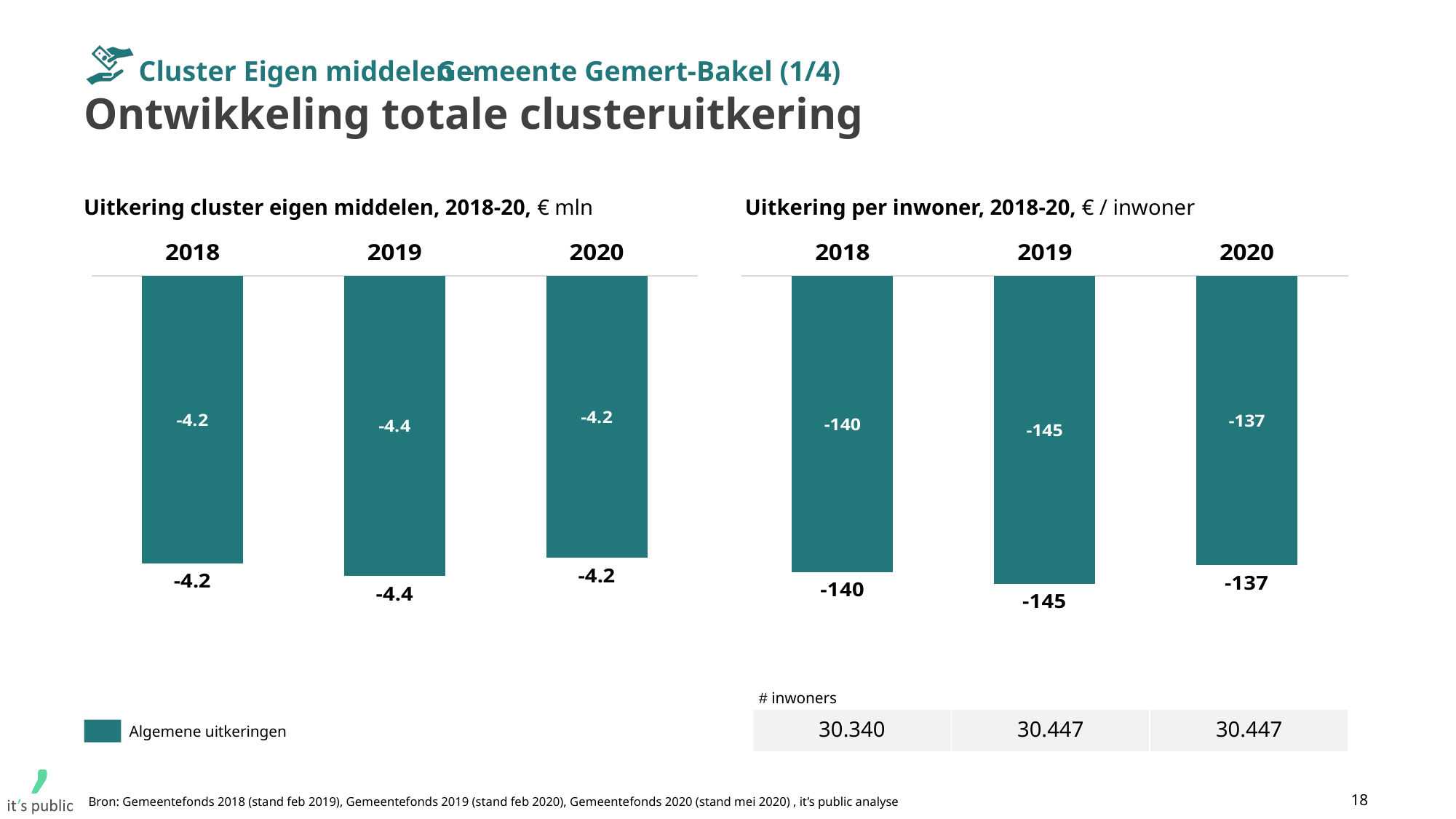
In the chart 'Uitkering cluster eigen middelen, 2018-20', which year has the lowest value? 2019 In the chart 'Uitkering cluster eigen middelen, 2018-20', what is the value for 2020? -4.2 In the chart 'Uitkering per inwoner, 2018-20', which year has the lowest value? 2019 In the chart 'Uitkering per inwoner, 2018-20', which year has the highest value? 2020 In the chart 'Uitkering cluster eigen middelen, 2018-20', is the value for 2018 larger or smaller than the value for 2019? larger In the chart 'Uitkering per inwoner, 2018-20', what is the value for 2018? -140 How many years are shown in the chart 'Uitkering per inwoner, 2018-20'? 3 In the chart 'Uitkering per inwoner, 2018-20', what is the value for 2020? -137 What type of chart is 'Uitkering cluster eigen middelen, 2018-20'? bar chart In the chart 'Uitkering cluster eigen middelen, 2018-20', what is the value for 2019? -4.4 In the chart 'Uitkering per inwoner, 2018-20', what is the difference between the values for 2018 and 2019? 5 In the chart 'Uitkering per inwoner, 2018-20', what is the difference between the values for 2019 and 2020? 8